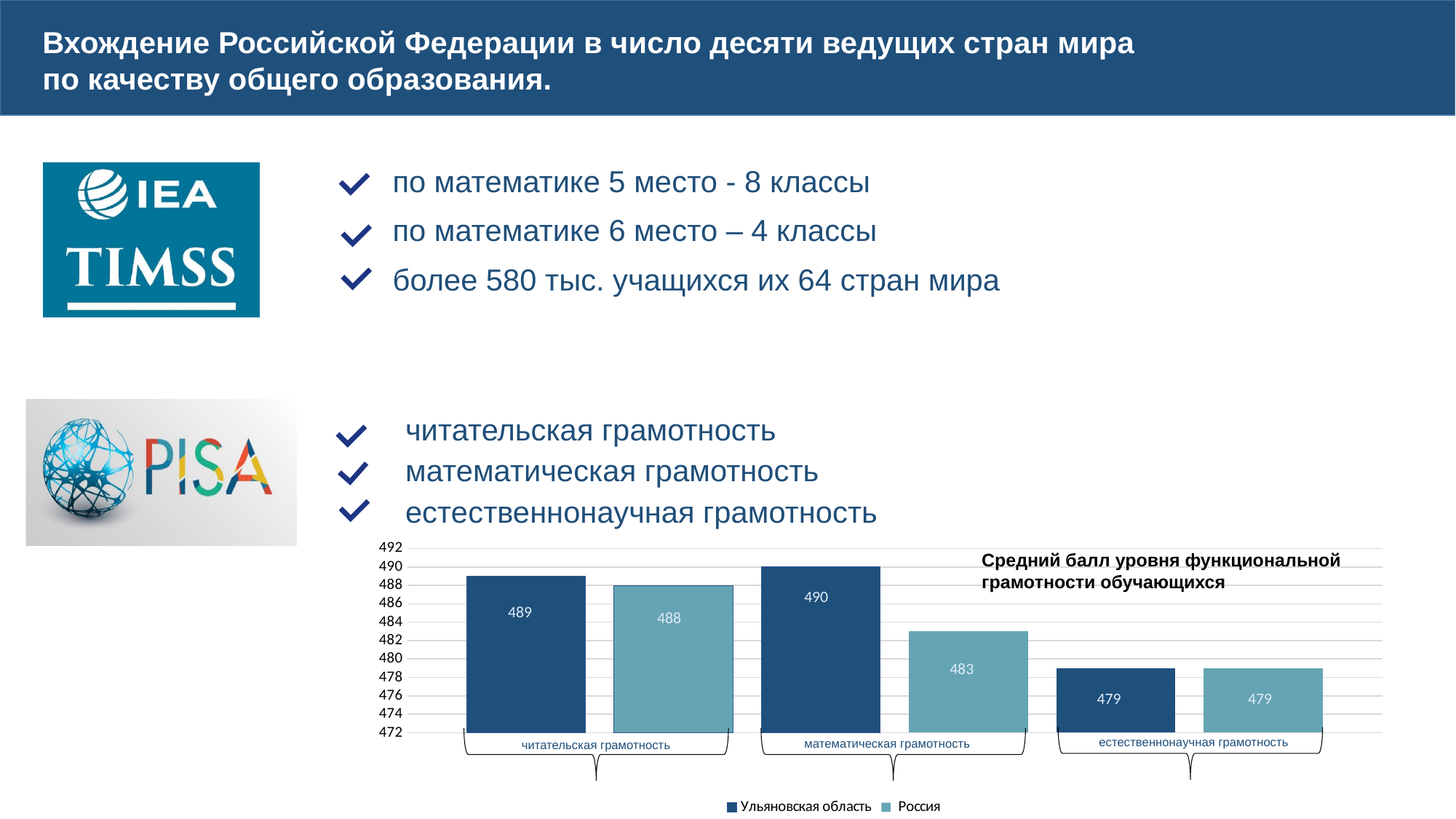
In which category does Россия have its lowest value? естественнонаучная грамотность Which is larger in читательская грамотность: Ульяновская область or Россия? Ульяновская область What is the value for Россия in естественнонаучная грамотность? 479 How many series does the chart legend list? 2 Which series is shown in the darker blue colour in the chart? Ульяновская область How many categories are shown on the x axis of the chart? 3 What is the title of the chart on the slide? Средний балл уровня функциональной грамотности обучающихся What type of chart is shown on the slide? bar chart What is the difference between Ульяновская область and Россия in математическая грамотность? 7 In which category does Ульяновская область have its highest value? математическая грамотность What is the value for Россия in математическая грамотность? 483 What is the value for Ульяновская область in читательская грамотность? 489